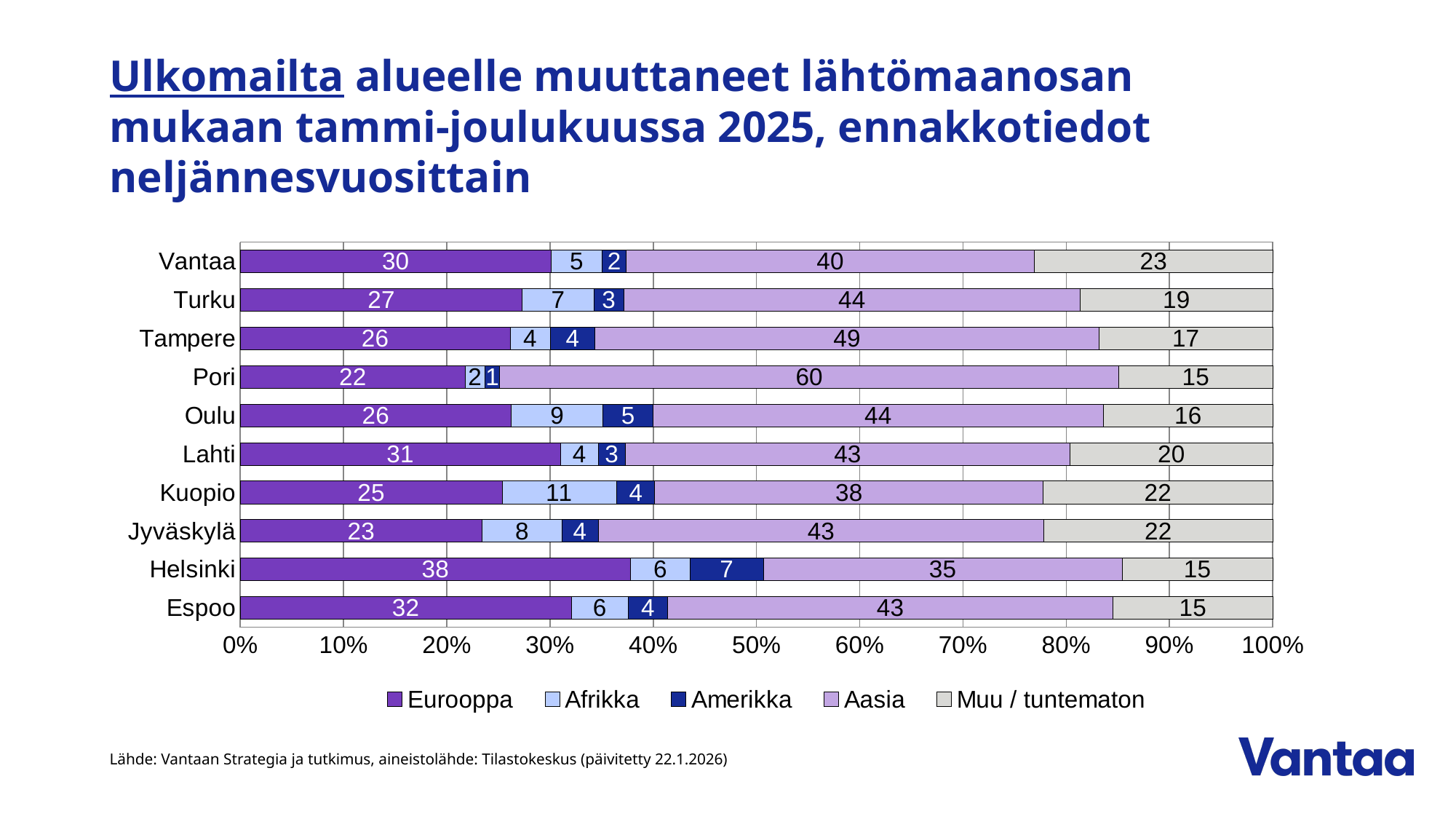
How many cities are shown on the chart? 10 What is the difference between the Aasia values for Pori and Vantaa? 20 What kind of chart is shown on the slide? Stacked bar chart Which city has the highest Eurooppa value? Helsinki What is the Muu / tuntematon value for Turku? 19 What is the Afrikka value for Kuopio? 11 What is the Aasia value for Pori? 60 What is the Eurooppa value for Vantaa? 30 How many series does the legend list? 5 Which is larger, the Amerikka value for Helsinki or for Oulu? Helsinki Which city has the lowest Aasia value? Helsinki Which legend entry is shown in the lightest grey colour? Muu / tuntematon